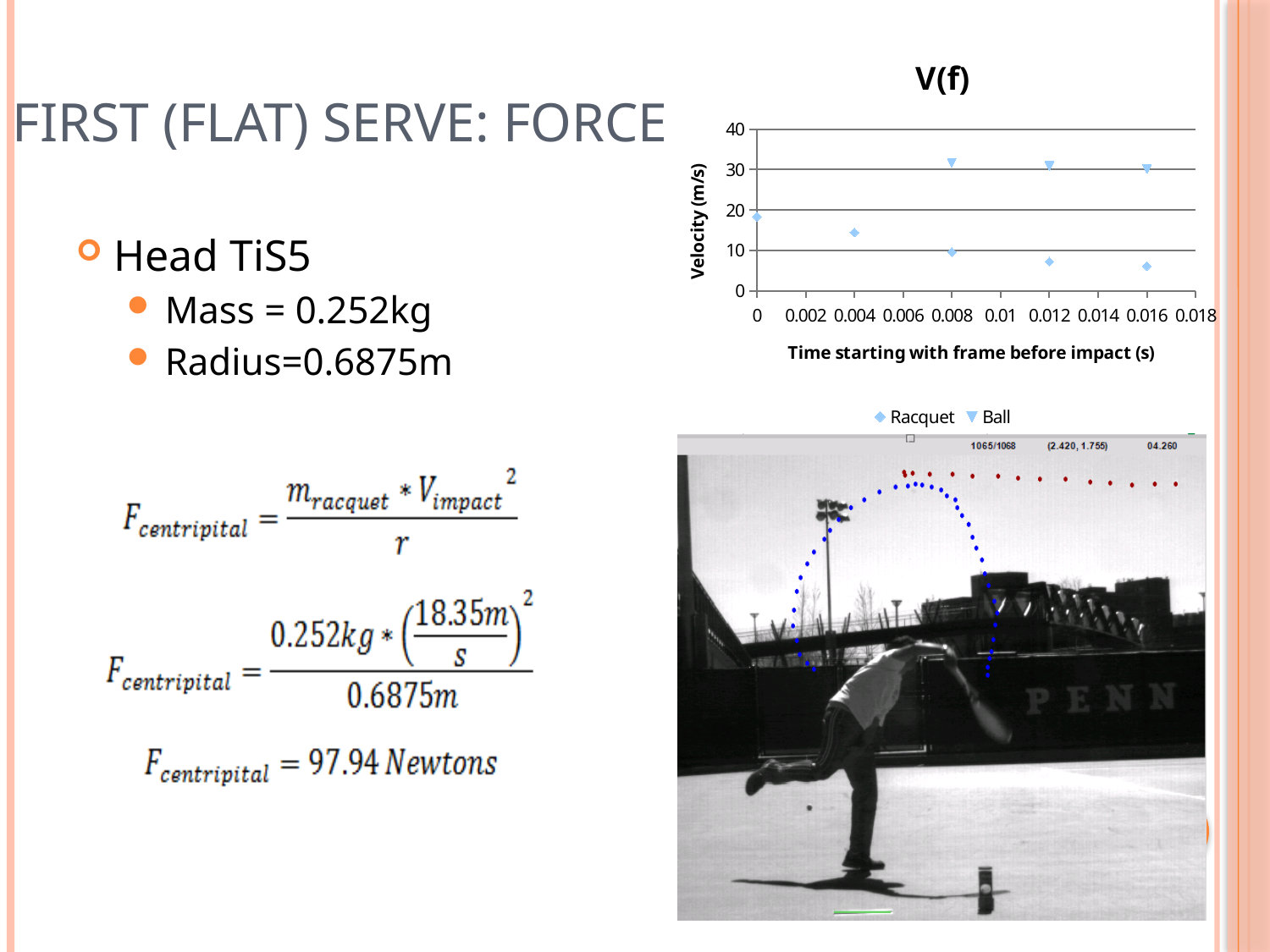
What kind of chart is the V(f) chart? scatter chart On the V(f) chart, is the Ball velocity at time 0.008 greater or less than 30 m/s? greater On the V(f) chart, at which time is the Racquet velocity highest? 0 On the V(f) chart, is the Racquet velocity at time 0.016 greater or less than 10 m/s? less How many series does the legend of the V(f) chart list? 2 What are the two series named in the legend of the V(f) chart? Racquet and Ball On the V(f) chart, does the Racquet velocity rise or fall as time increases? fall On the V(f) chart, is the Racquet velocity at time 0 greater or less than 10 m/s? greater On the V(f) chart, at time 0.012, which series has the higher velocity, Racquet or Ball? Ball How many Ball points are plotted on the V(f) chart? 3 How many Racquet points are plotted on the V(f) chart? 5 What is the title of the chart on the slide? V(f)